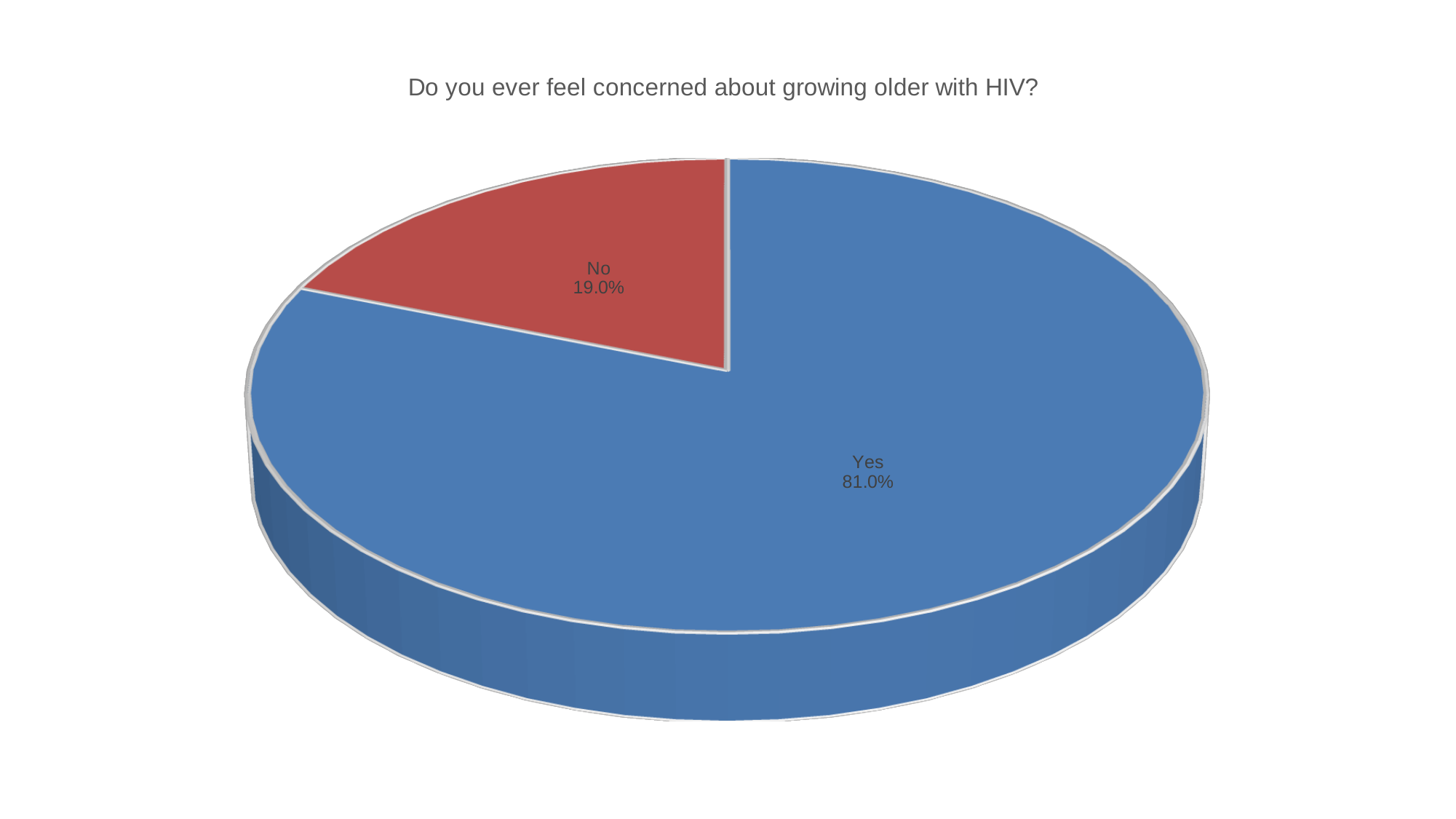
What share of the pie does the No slice represent? 19.0% Which response has the largest share of the pie? Yes What kind of chart is shown on the slide? Pie chart What is the title of the chart? Do you ever feel concerned about growing older with HIV? What percentage of respondents answered No? 19.0% What is the difference in percentage points between the Yes and No shares? 62.0 Which is larger, the share for Yes or the share for No? Yes What percentage of respondents answered Yes? 81.0% Which response has the smallest share of the pie? No What colour is the Yes slice? Blue How many slices does the pie chart have? 2